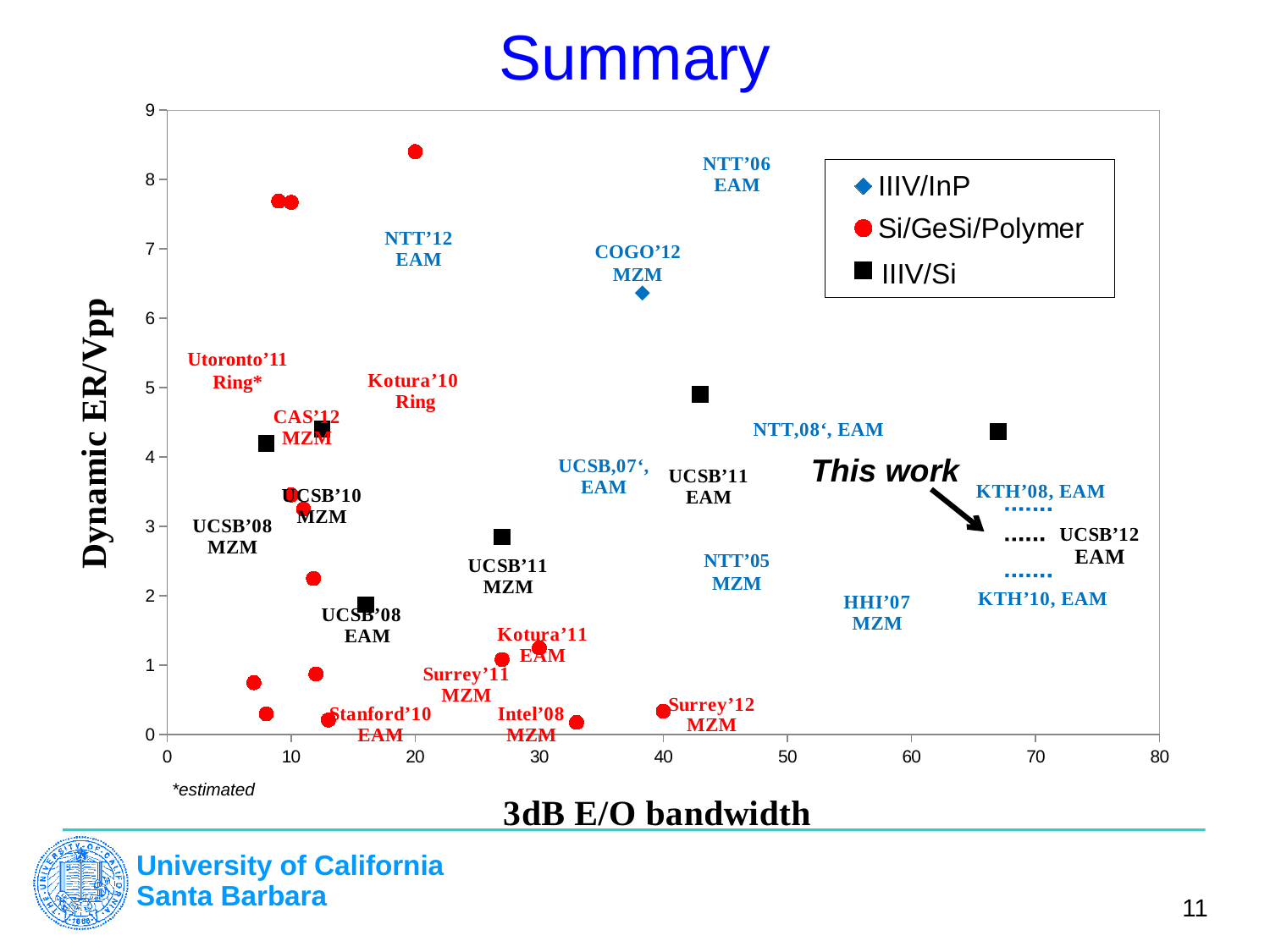
What is the maximum value shown on the horizontal axis? 80 What kind of chart is shown on the slide? scatter chart Is the 3dB E/O bandwidth of the rightmost IIIV/Si point greater or less than 60? greater Is the Dynamic ER/Vpp of the highest Si/GeSi/Polymer point greater or less than 8? greater How many IIIV/InP (blue diamond) points are plotted on the chart? 1 How many series does the legend list? 3 Is the Dynamic ER/Vpp of the IIIV/InP point (COGO'12 MZM) greater or less than 5? greater Which series contains the point with the highest Dynamic ER/Vpp? Si/GeSi/Polymer Which series does the rightmost plotted point belong to? IIIV/Si Which series is shown with blue diamond markers in the legend? IIIV/InP What is the title of the vertical axis? Dynamic ER/Vpp